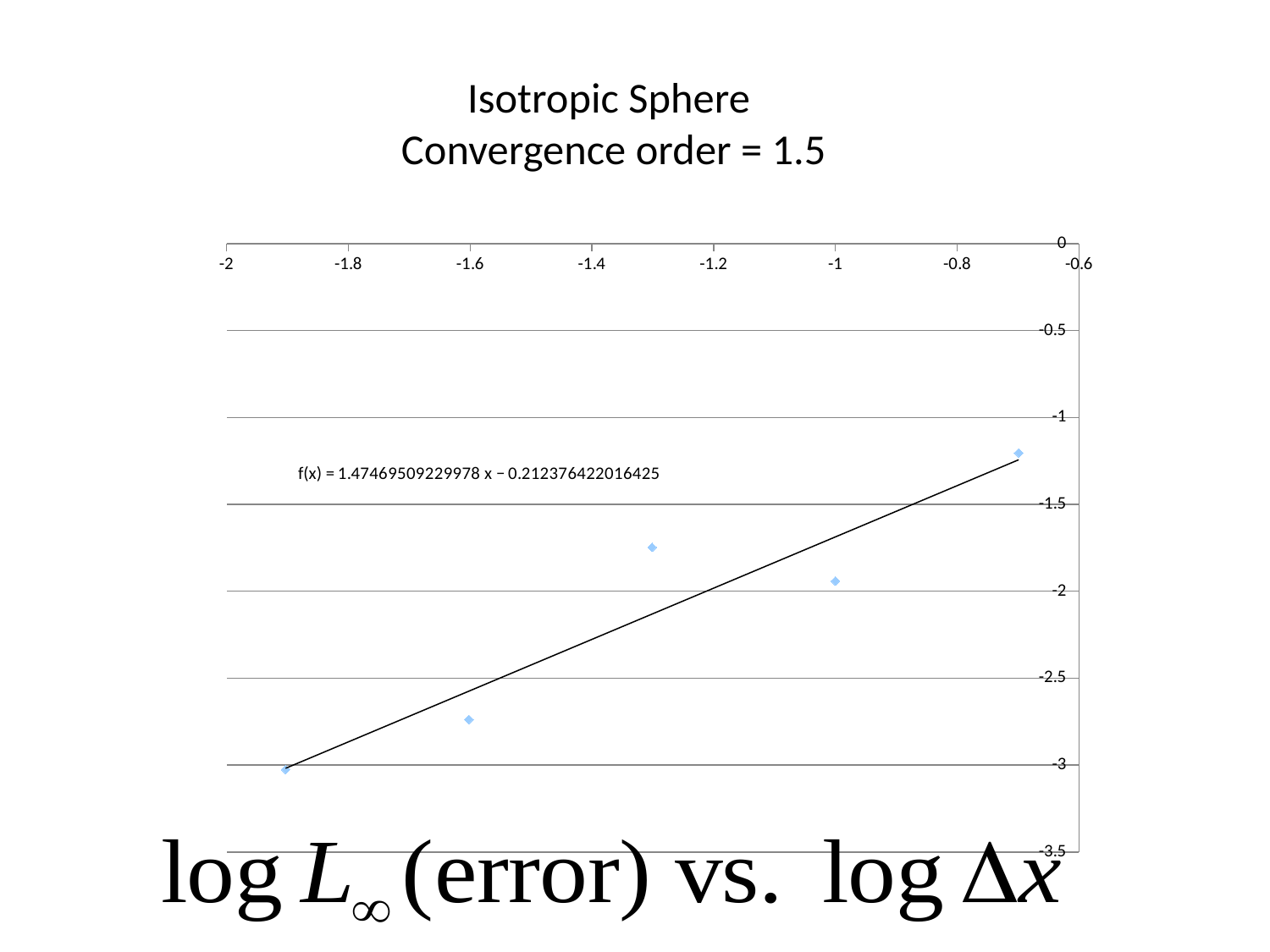
Is the y value of the data point near x = -1.6 greater or less than -2.5? less What is the title of the chart? Isotropic Sphere Convergence order = 1.5 What kind of chart is shown on the slide? scatter chart Which data point has the lowest y value on the chart? the one near x = -1.9 Which has the larger y value: the data point near x = -1.3 or the data point near x = -1? the data point near x = -1.3 Is the y value of the data point near x = -0.7 greater or less than -1.5? greater Is the y value of the data point near x = -1.3 greater or less than -2? greater How many data points are plotted on the chart? 5 Do the plotted values rise or fall as x increases from -2 to -0.6? rise What is the slope of the fitted trendline equation shown on the chart? 1.47469509229978 Which has the larger y value: the data point near x = -1.6 or the data point near x = -1.9? the data point near x = -1.6 Which data point has the highest y value: the one near x = -0.7 or the one near x = -1.9? the one near x = -0.7